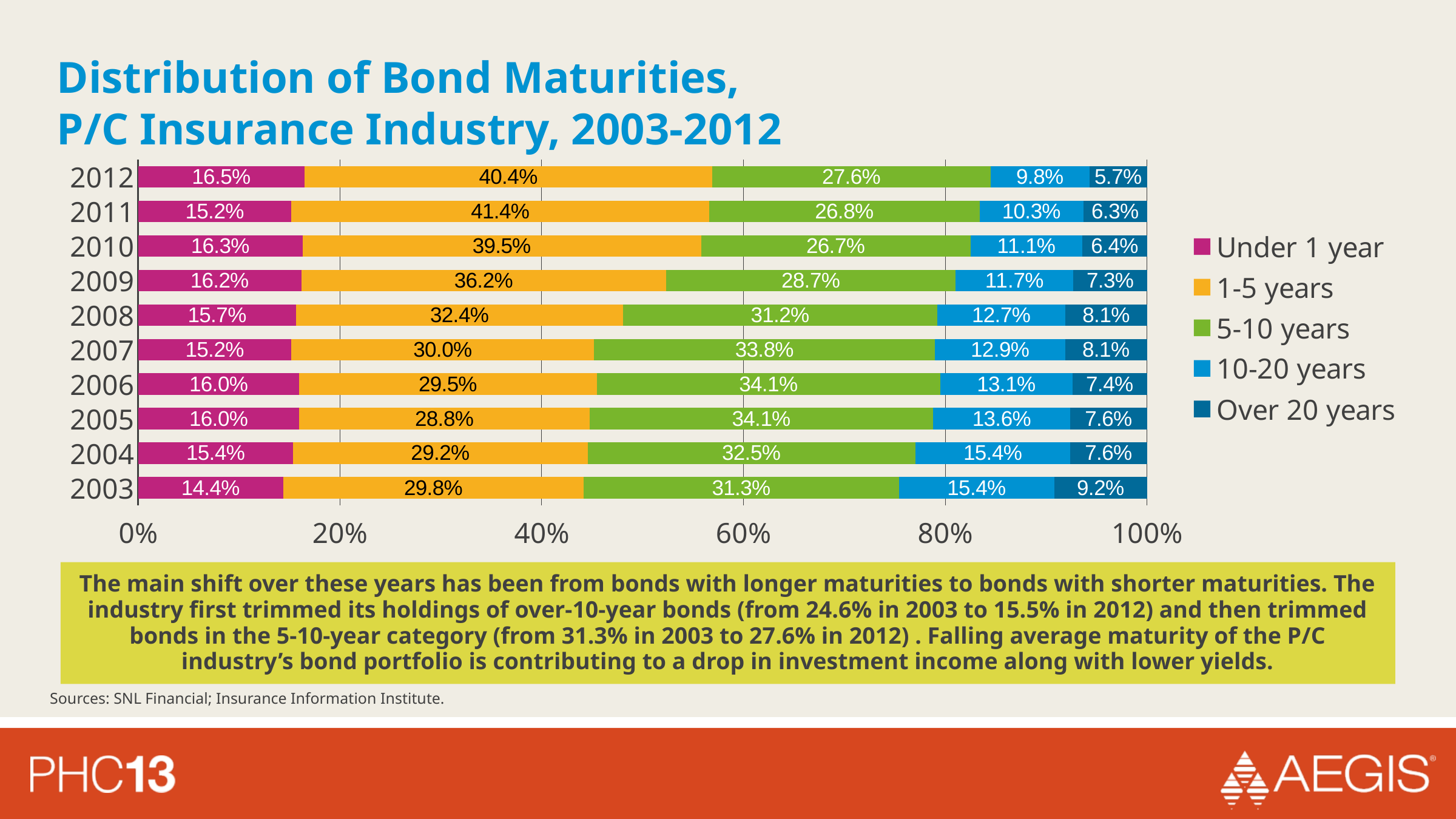
Which is larger: the 10-20 years share in 2004 or in 2012? 2004 What was the 5-10 years share in 2006? 34.1% Which year had the lowest Under 1 year share? 2003 What share of bonds had a 1-5 years maturity in 2012? 40.4% What was the Over 20 years share in 2003? 9.2% How many years are shown on the chart? 10 What kind of chart is shown? Stacked bar chart Which colour represents the 5-10 years series? Green What is the difference between the 1-5 years share in 2012 and in 2003? 10.6% How many series does the legend list? 5 Which year had the highest 1-5 years share? 2011 Does the Over 20 years share rise or fall from 2003 to 2012? Fall